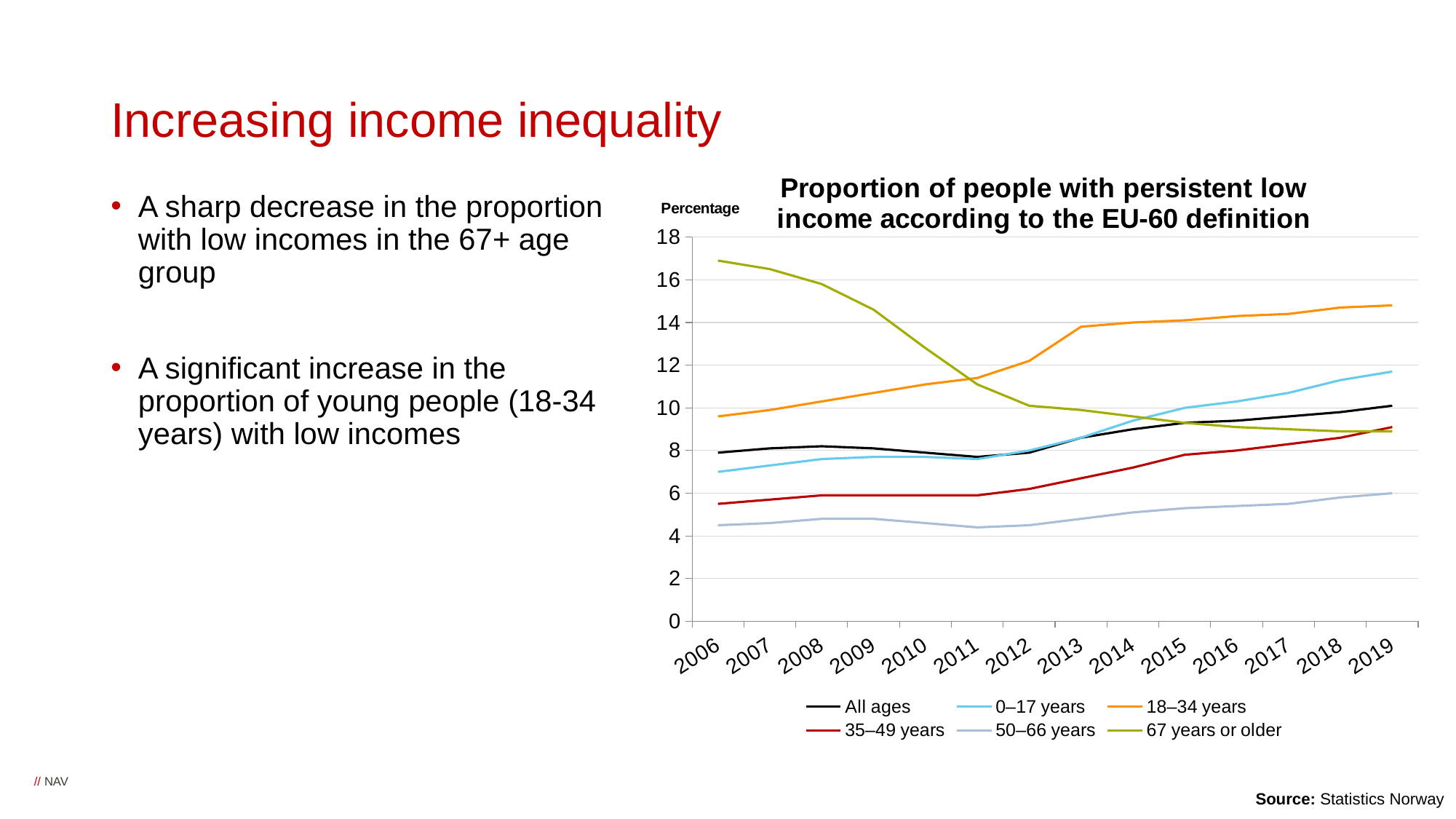
Which age group has the lowest value in 2019? 50–66 years What is the title of the chart? Proportion of people with persistent low income according to the EU-60 definition Does the line for 18–34 years rise or fall from 2006 to 2019? rise Which age group has the highest value in 2019? 18–34 years What kind of chart is shown on the slide? line chart How many years are shown on the x axis? 14 Is the value for 67 years or older in 2006 greater or less than 16? greater How many series does the legend list? 6 Is the value for 50–66 years in 2011 greater or less than 6? less Which age group has the highest value in 2006? 67 years or older Does the line for 67 years or older rise or fall from 2006 to 2019? fall In 2019, which is larger: the value for 0–17 years or the value for 35–49 years? 0–17 years